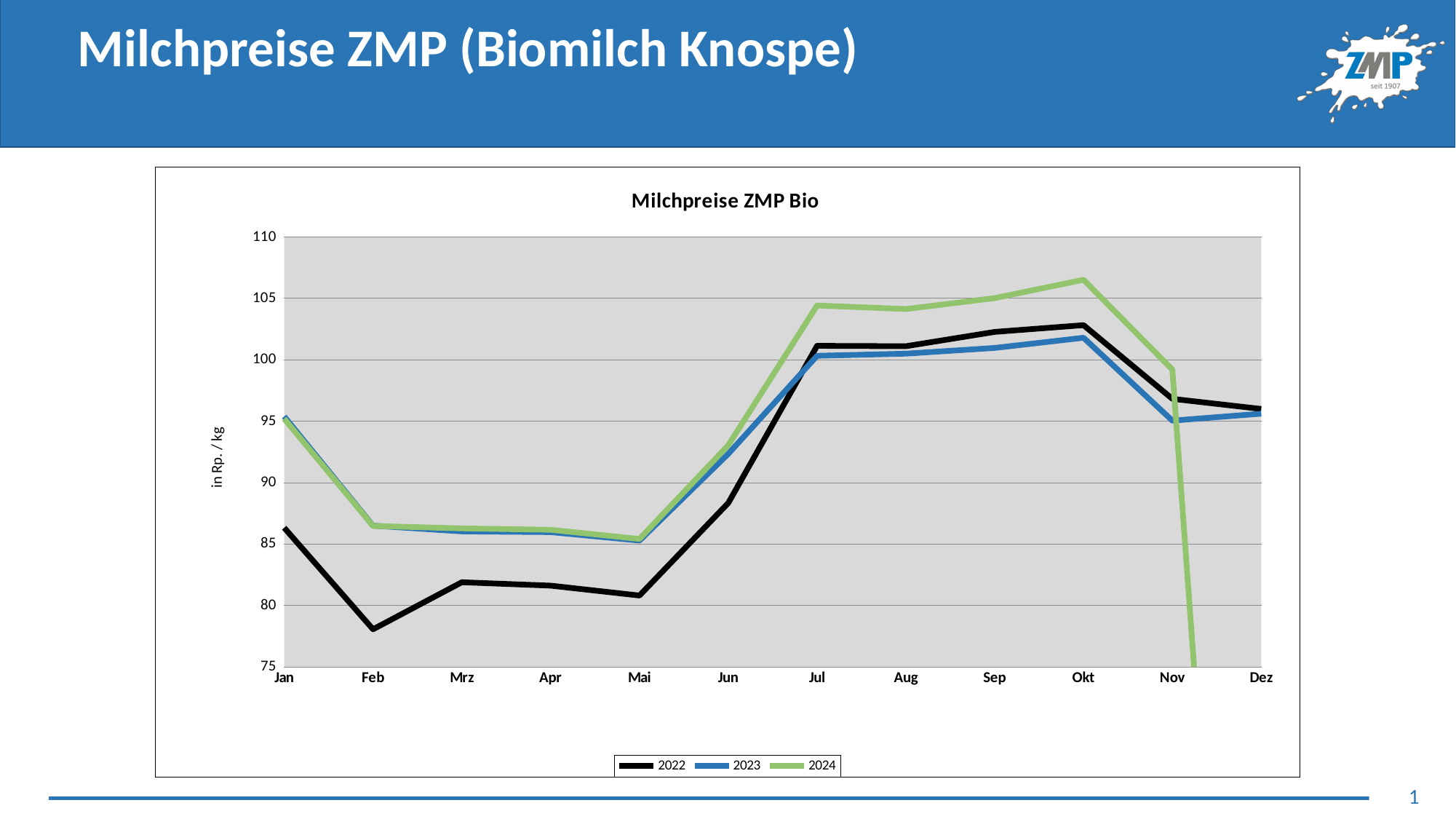
Is the value for 2022 in Feb greater or less than 80? less What is the title of the chart? Milchpreise ZMP Bio How many months are shown on the x axis? 12 In Jan, which series has the higher value, 2022 or 2023? 2023 How many series does the legend list? 3 Does the 2022 series rise or fall from Mai to Jul? rise What is the label of the vertical axis? in Rp. / kg In Sep, which series has the higher value, 2022 or 2024? 2024 In which month does the 2022 series reach its lowest value? Feb What kind of chart is shown on the slide? line chart Is the value for 2024 in Okt greater or less than 105? greater Is the value for 2023 in Nov greater or less than 100? less